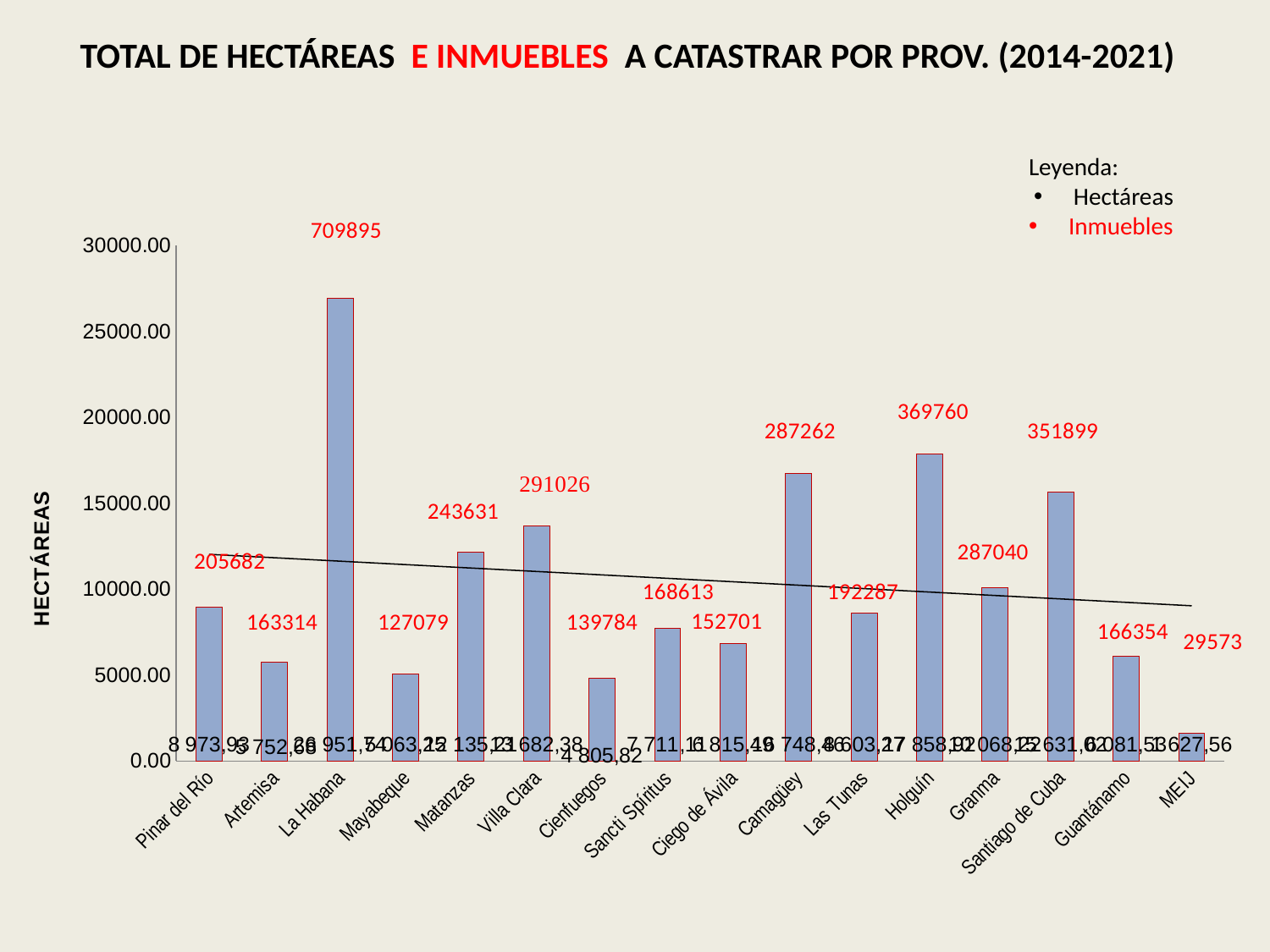
What is the number of inmuebles (red label) for Holguín? 369760 Which province has the shortest bar for hectáreas? MEIJ Which province has the tallest bar for hectáreas? La Habana Is the hectáreas value for Las Tunas greater or less than 10000.00? less Is the hectáreas value for Camagüey greater or less than 15000.00? greater What is the number of inmuebles (red label) for La Habana? 709895 What is the difference in inmuebles between Holguín (369760) and Santiago de Cuba (351899)? 17861 Which province has more inmuebles, Villa Clara or Matanzas? Villa Clara How many entries does the legend (Leyenda) list? 2 What kind of chart is shown on the slide? bar chart What is the hectáreas value printed for Pinar del Río? 8 973,93 How many provinces (categories) are shown on the x axis? 16